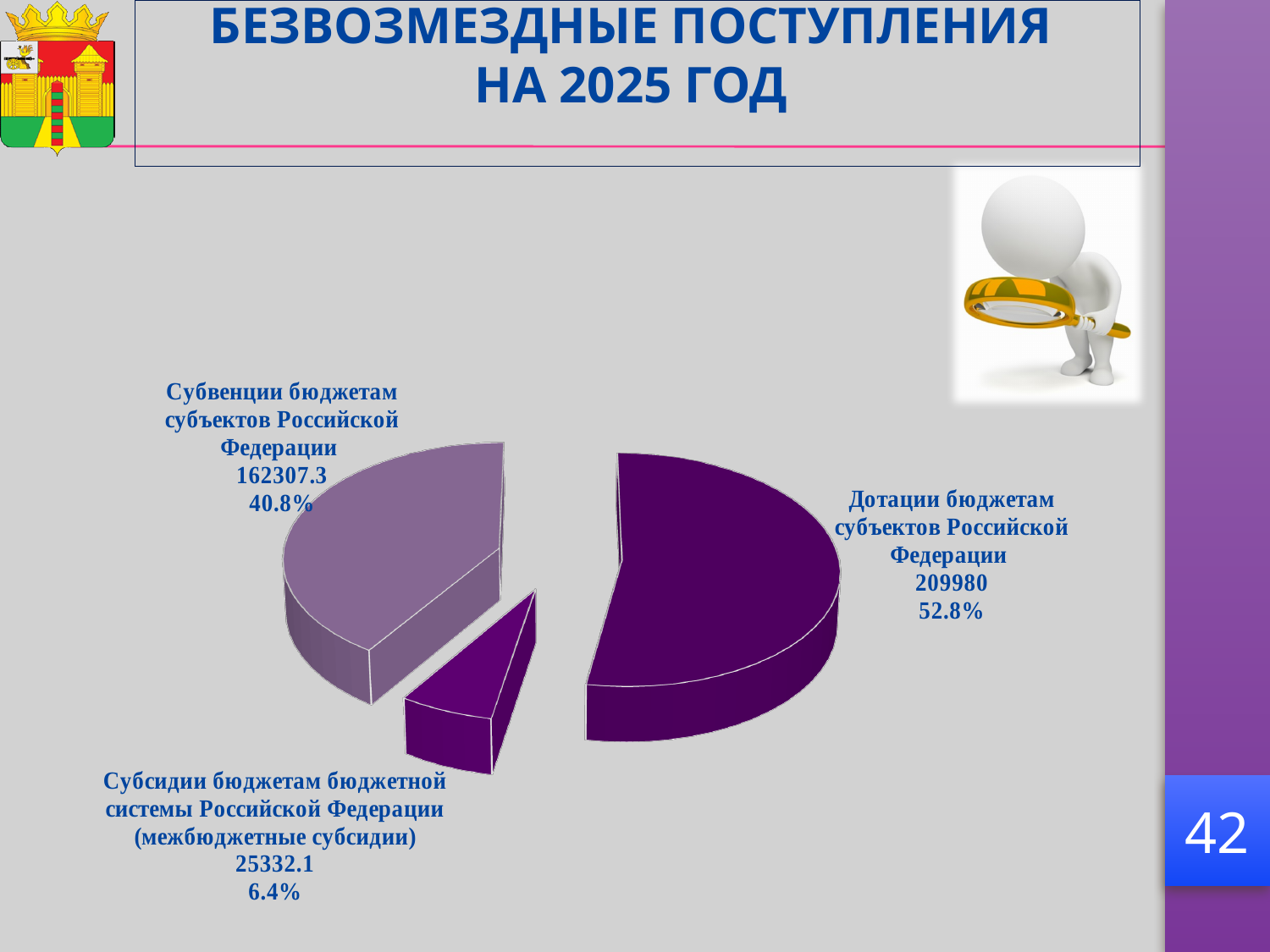
How many categories are shown in the pie chart? 3 What share of the pie does Субсидии бюджетам бюджетной системы Российской Федерации (межбюджетные субсидии) represent? 6.4% What is the value for Субсидии бюджетам бюджетной системы Российской Федерации (межбюджетные субсидии)? 25332.1 What is the title of the slide containing the pie chart? БЕЗВОЗМЕЗДНЫЕ ПОСТУПЛЕНИЯ НА 2025 ГОД Which category has the smallest slice of the pie? Субсидии бюджетам бюджетной системы Российской Федерации (межбюджетные субсидии) What type of chart is shown on the slide? Pie chart Which category has the largest slice of the pie? Дотации бюджетам субъектов Российской Федерации Which is larger: the value for Субвенции бюджетам субъектов Российской Федерации or the value for Субсидии бюджетам бюджетной системы Российской Федерации (межбюджетные субсидии)? Субвенции бюджетам субъектов Российской Федерации What is the value for Дотации бюджетам субъектов Российской Федерации? 209980 What share of the pie does Дотации бюджетам субъектов Российской Федерации represent? 52.8% What is the difference between the values for Дотации бюджетам субъектов Российской Федерации and Субвенции бюджетам субъектов Российской Федерации? 47672.7 What is the value for Субвенции бюджетам субъектов Российской Федерации? 162307.3